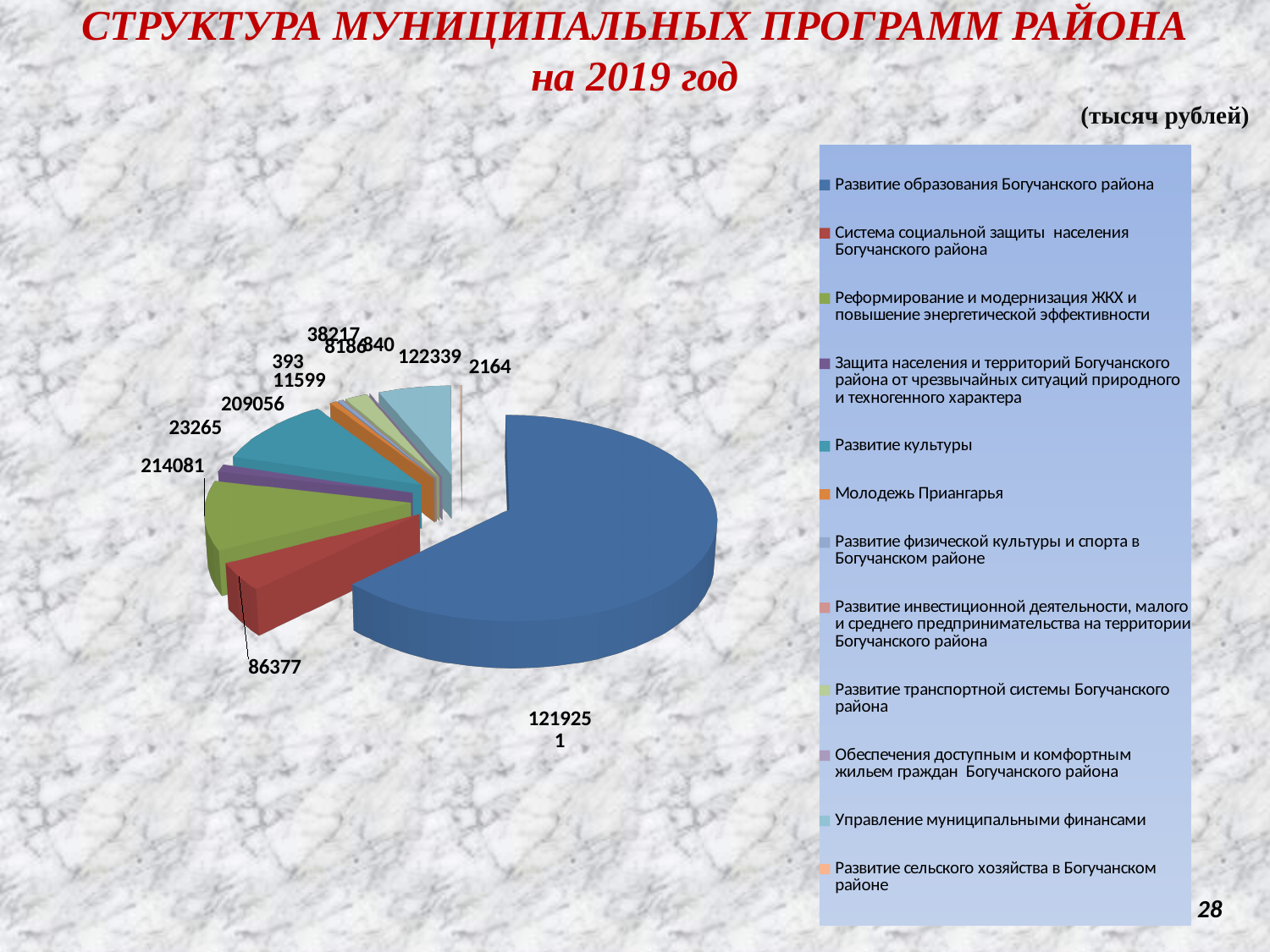
Which is larger: the value for Реформирование и модернизация ЖКХ or the value for Развитие культуры? Реформирование и модернизация ЖКХ What is the difference between the value for Реформирование и модернизация ЖКХ (214081) and the value for Система социальной защиты населения (86377)? 127704 How many categories does the legend of the pie chart list? 12 What year does the chart title refer to? 2019 What is the value for Реформирование и модернизация ЖКХ и повышение энергетической эффективности? 214081 What is the value for Система социальной защиты населения Богучанского района? 86377 In what units are the values on the chart given, according to the slide? тысяч рублей What is the value for Управление муниципальными финансами? 122339 What kind of chart is shown on the slide? pie chart What is the value for Развитие культуры? 209056 Which category has the largest slice of the pie chart? Развитие образования Богучанского района What is the value for Защита населения и территорий Богучанского района от чрезвычайных ситуаций природного и техногенного характера? 23265